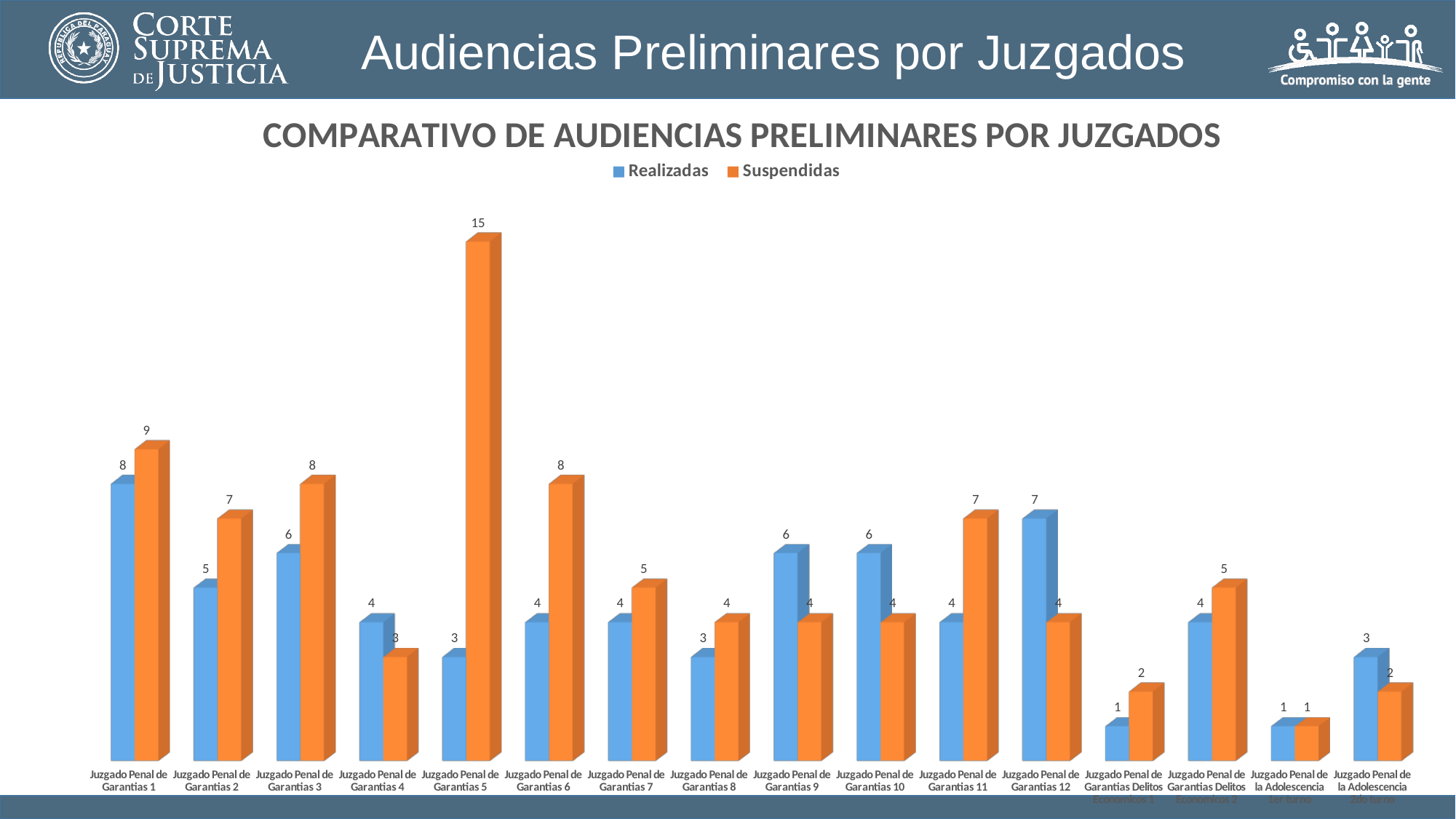
For Juzgado Penal de Garantias 9, which is larger, Realizadas or Suspendidas? Realizadas Which juzgado has the highest Realizadas value? Juzgado Penal de Garantias 1 How many series does the legend list? 2 What kind of chart is shown on the slide? Bar chart How many juzgados (categories) are shown on the x axis? 16 For Juzgado Penal de Garantias 5, what is the difference between Suspendidas and Realizadas? 12 What is the Realizadas value for Juzgado Penal de Garantias 12? 7 What is the Suspendidas value for Juzgado Penal de Garantias 5? 15 What is the Realizadas value for Juzgado Penal de Garantias 4? 4 Which juzgado has the highest Suspendidas value? Juzgado Penal de Garantias 5 For Juzgado Penal de Garantias 3, how much larger is Suspendidas than Realizadas? 2 What is the title of the chart? COMPARATIVO DE AUDIENCIAS PRELIMINARES POR JUZGADOS